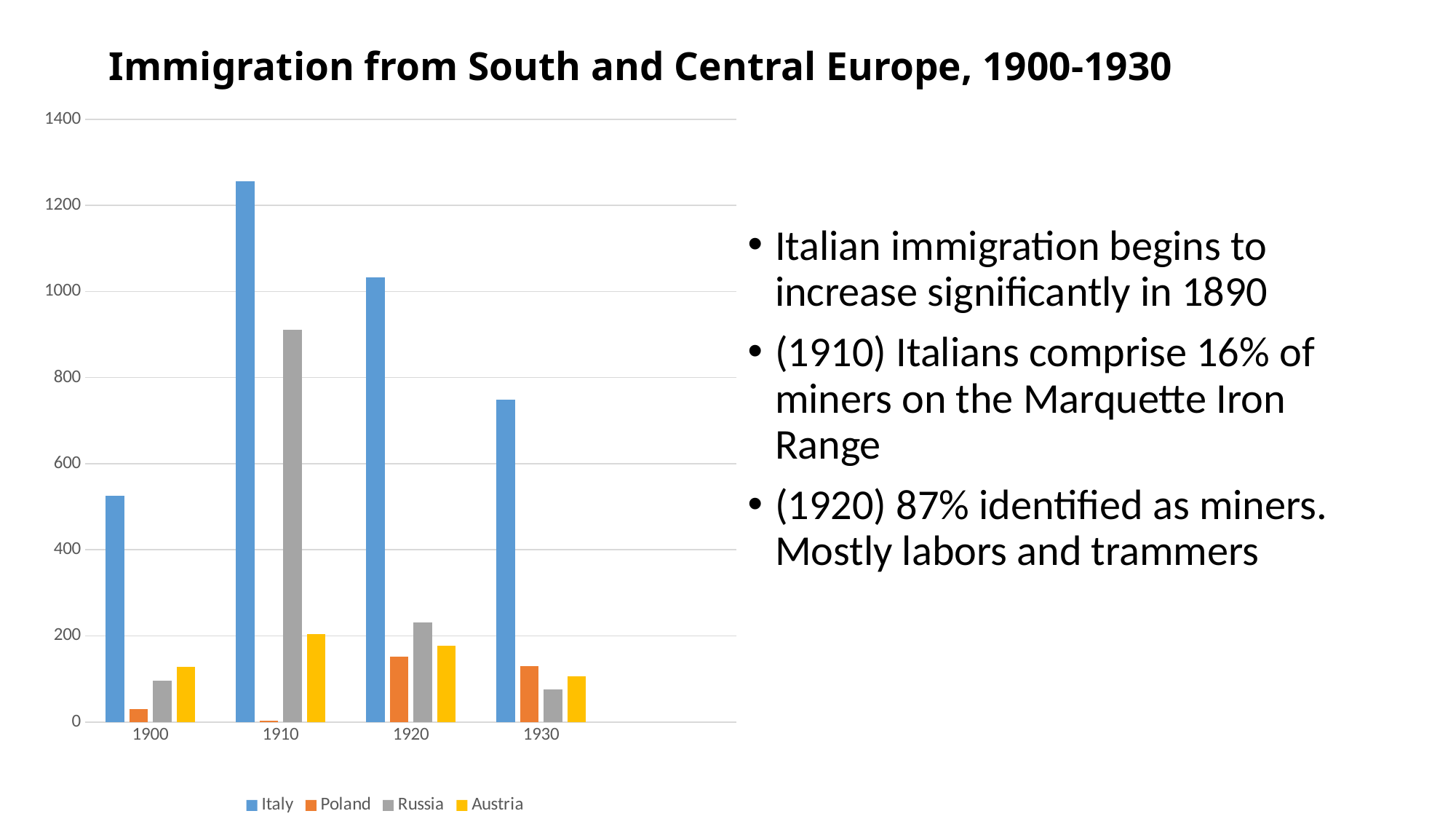
In 1930, which is larger, the value for Poland or the value for Russia? Poland In which year is the Italy bar the highest? 1910 In 1920, which is larger, the value for Poland or the value for Russia? Russia What kind of chart is shown on the slide? bar chart Do the values for Italy rise or fall from 1910 to 1930? fall How many series does the chart legend list? 4 Is the value for Russia in 1910 greater or less than 1000? less In which year is the Poland bar the lowest? 1910 How many years are shown along the x axis of the chart? 4 What is the title of the chart? Immigration from South and Central Europe, 1900-1930 Is the value for Italy in 1900 greater or less than 400? greater Is the value for Italy in 1910 greater or less than 1200? greater